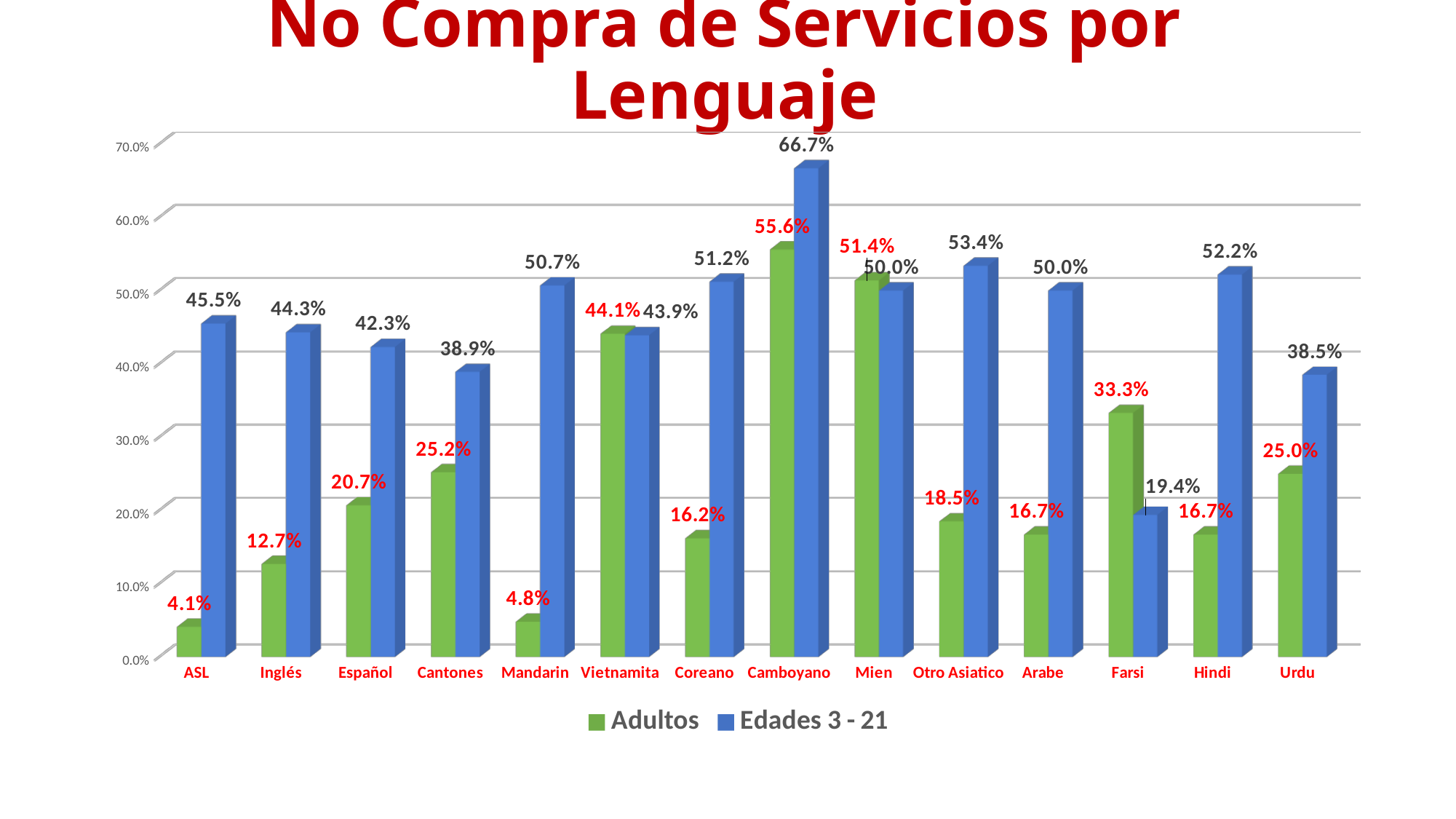
What is the value for Edades 3 - 21 for Mandarin? 50.7% Which language has the lowest value for Adultos? ASL For Farsi, which series has the larger value, Adultos or Edades 3 - 21? Adultos What is the value for Adultos for Camboyano? 55.6% What is the difference between the Edades 3 - 21 value and the Adultos value for Camboyano? 11.1 percentage points Which language has the highest value for Edades 3 - 21? Camboyano How many languages are shown on the x axis? 14 Which language has the lowest value for Edades 3 - 21? Farsi What is the value for Adultos for Farsi? 33.3% What kind of chart is shown on the slide? Bar chart How many series does the legend list? 2 What is the title of the chart? No Compra de Servicios por Lenguaje